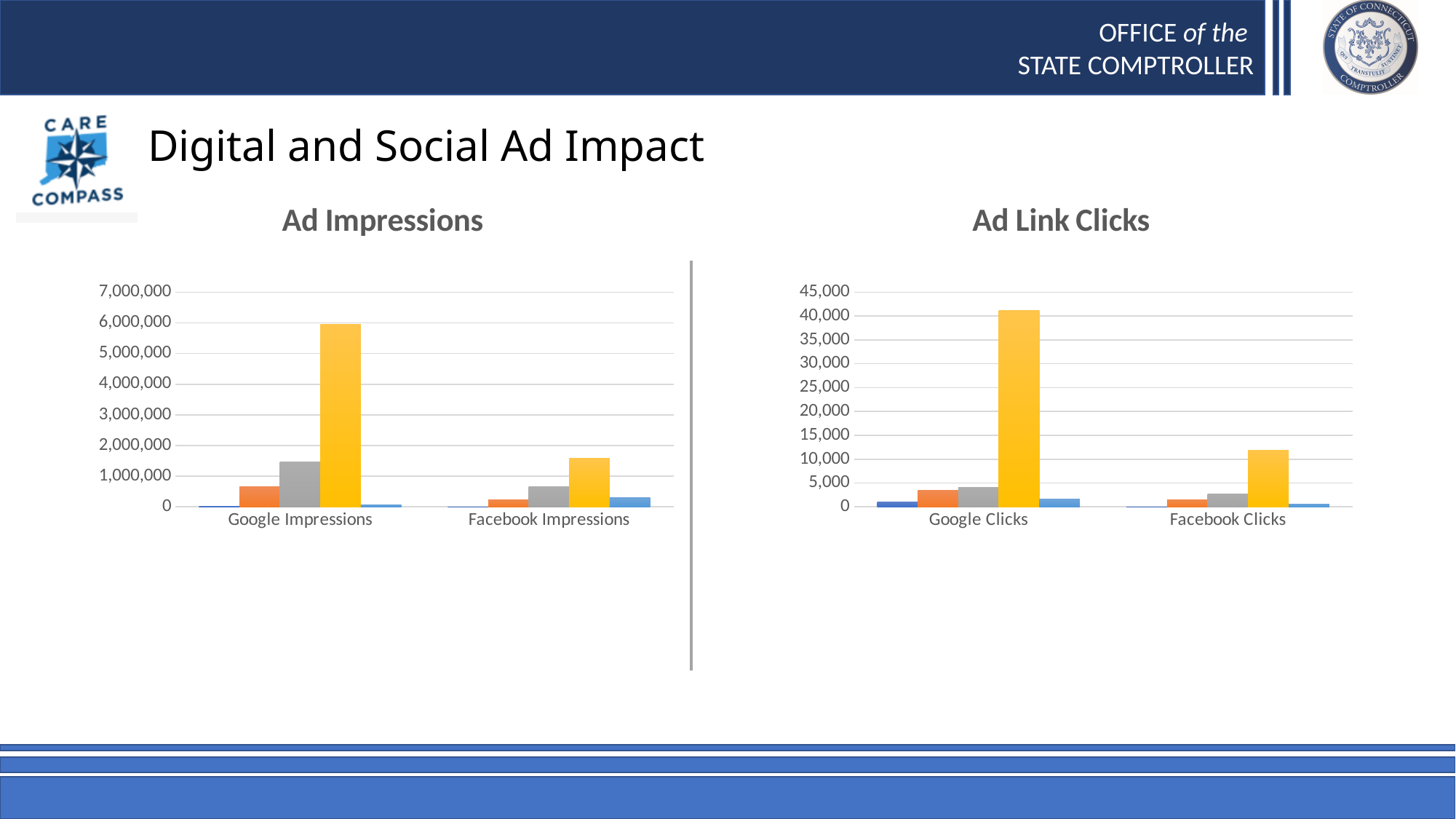
In the "Ad Link Clicks" chart, is the yellow bar for Facebook Clicks greater or less than 15,000? less In the "Ad Impressions" chart, is the yellow bar for Facebook Impressions greater or less than 2,000,000? less What is the title of the chart on the left side of the slide? Ad Impressions In the "Ad Link Clicks" chart, is the yellow bar for Google Clicks greater or less than 35,000? greater In the "Ad Impressions" chart, which category has the taller yellow bar, Google Impressions or Facebook Impressions? Google Impressions How many categories are shown on the x axis of the "Ad Impressions" chart? 2 What is the highest tick value shown on the y axis of the "Ad Link Clicks" chart? 45,000 What kind of chart is the "Ad Impressions" chart? bar chart In the "Ad Link Clicks" chart, which category contains the tallest bar overall? Google Clicks How many categories are shown on the x axis of the "Ad Link Clicks" chart? 2 In the "Ad Link Clicks" chart, which category has the taller gray bar, Google Clicks or Facebook Clicks? Google Clicks